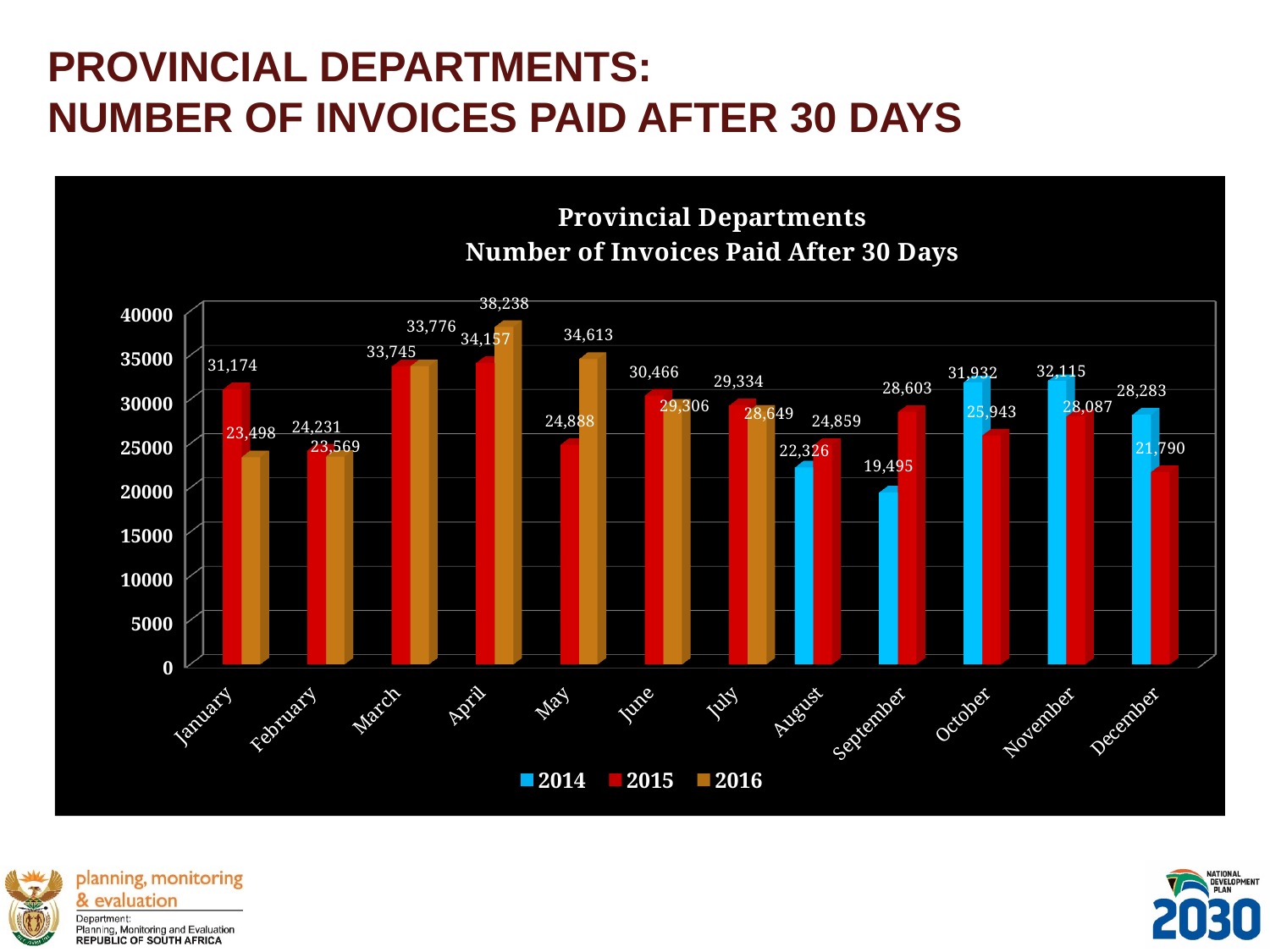
What is the 2015 value for January? 31,174 What is the 2016 value for April? 38,238 In October, which series has the larger value, 2014 or 2015? 2014 Is the 2014 value for August greater or less than 20000? greater What kind of chart is shown on the slide? bar chart What is the difference between the 2016 and 2015 values for April? 4,081 What is the difference between the 2014 and 2015 values for December? 6,493 How many months are shown on the x axis? 12 Which month has the lowest 2014 value? September How many series does the legend list? 3 What is the 2014 value for September? 19,495 Which month has the highest 2016 value? April